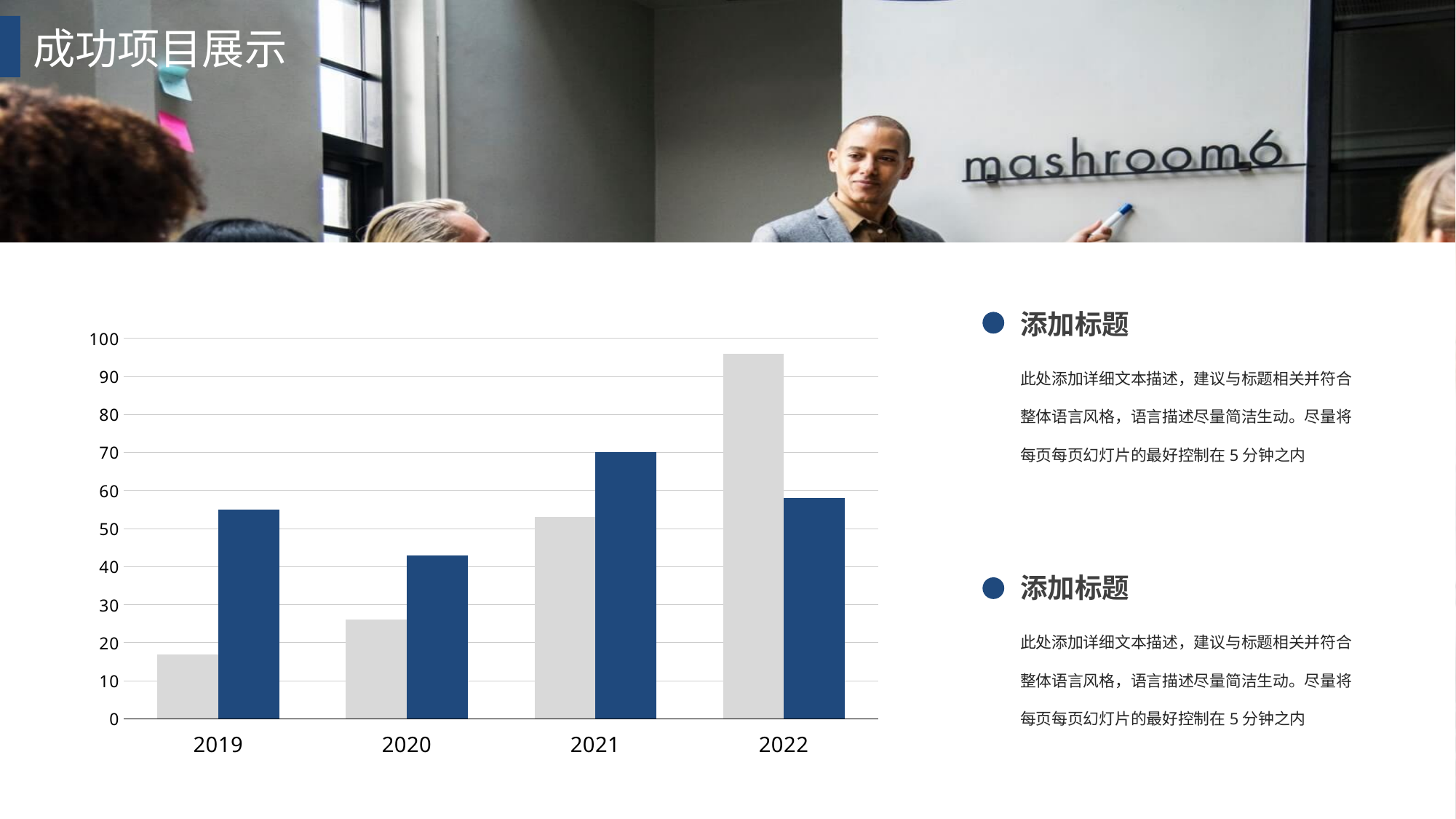
Do the grey bars rise or fall from 2019 to 2022? rise Which year has the shortest blue bar? 2020 Which year has the tallest blue bar? 2021 In 2019, which bar is taller, the grey bar or the blue bar? the blue bar Is the grey bar for 2019 greater or less than 20? less Which year has the tallest grey bar? 2022 Is the grey bar for 2022 greater or less than 90? greater Which year has the shortest grey bar? 2019 How many years are shown on the x axis of the chart? 4 In 2022, which bar is taller, the grey bar or the blue bar? the grey bar What kind of chart is shown on the slide? bar chart Is the blue bar for 2020 greater or less than 40? greater